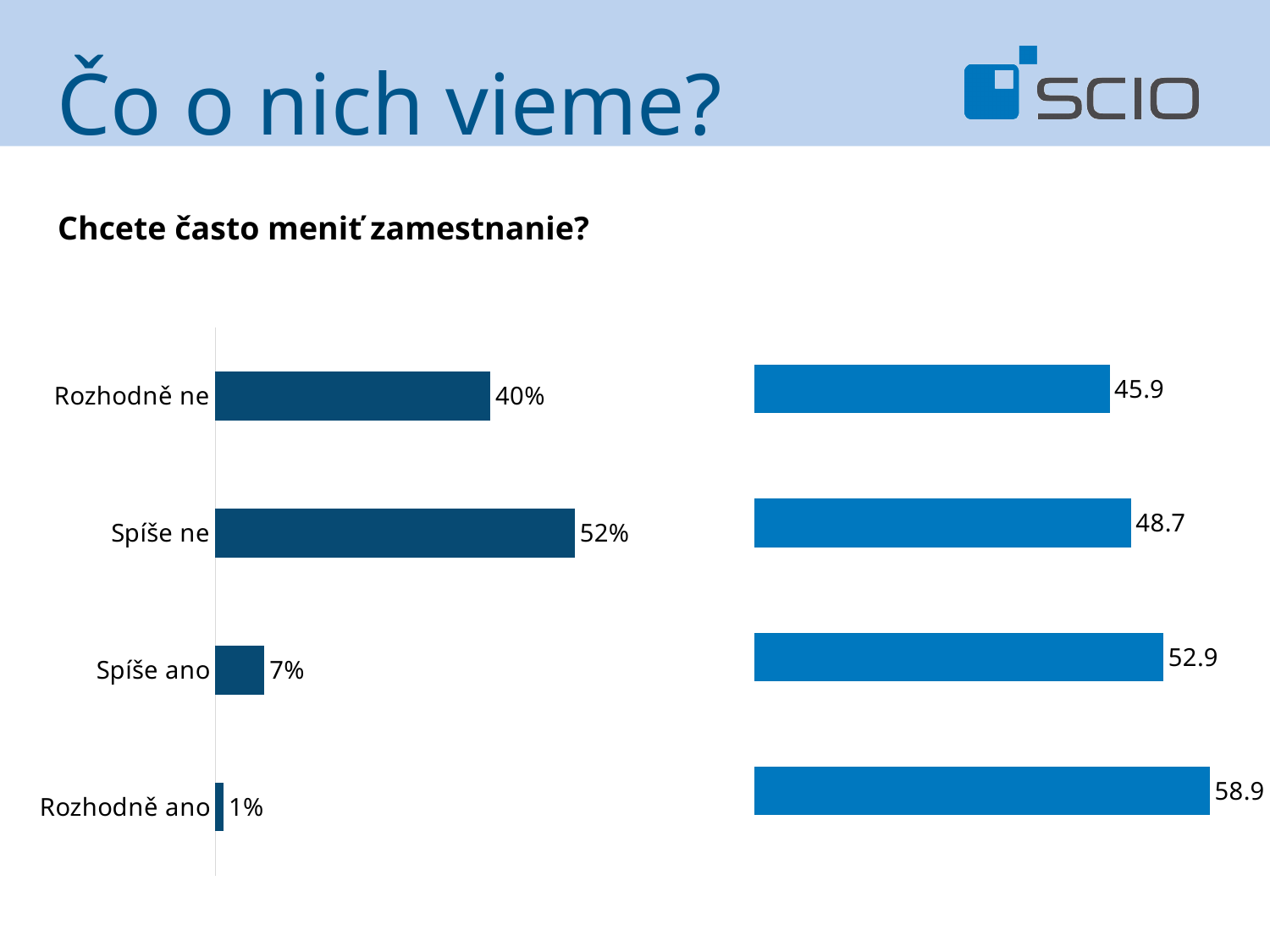
In the left chart, which is larger: the value for Rozhodně ne or the value for Spíše ano? Rozhodně ne In the left chart, which category has the highest value? Spíše ne What question is shown as the heading above the charts? Chcete často meniť zamestnanie? In the left chart, what is the difference between the values for Spíše ne and Rozhodně ne? 12% In the left chart, which category has the lowest value? Rozhodně ano In the left chart, what is the value for Spíše ne? 52% In the left chart, what is the value for Rozhodně ano? 1% What kind of chart is the left chart? bar chart In the right chart, what is the difference between the bottom bar and the top bar? 13.0 In the right chart, what is the value of the bottom bar? 58.9 How many categories does the left chart show? 4 In the right chart, what is the value of the top bar? 45.9